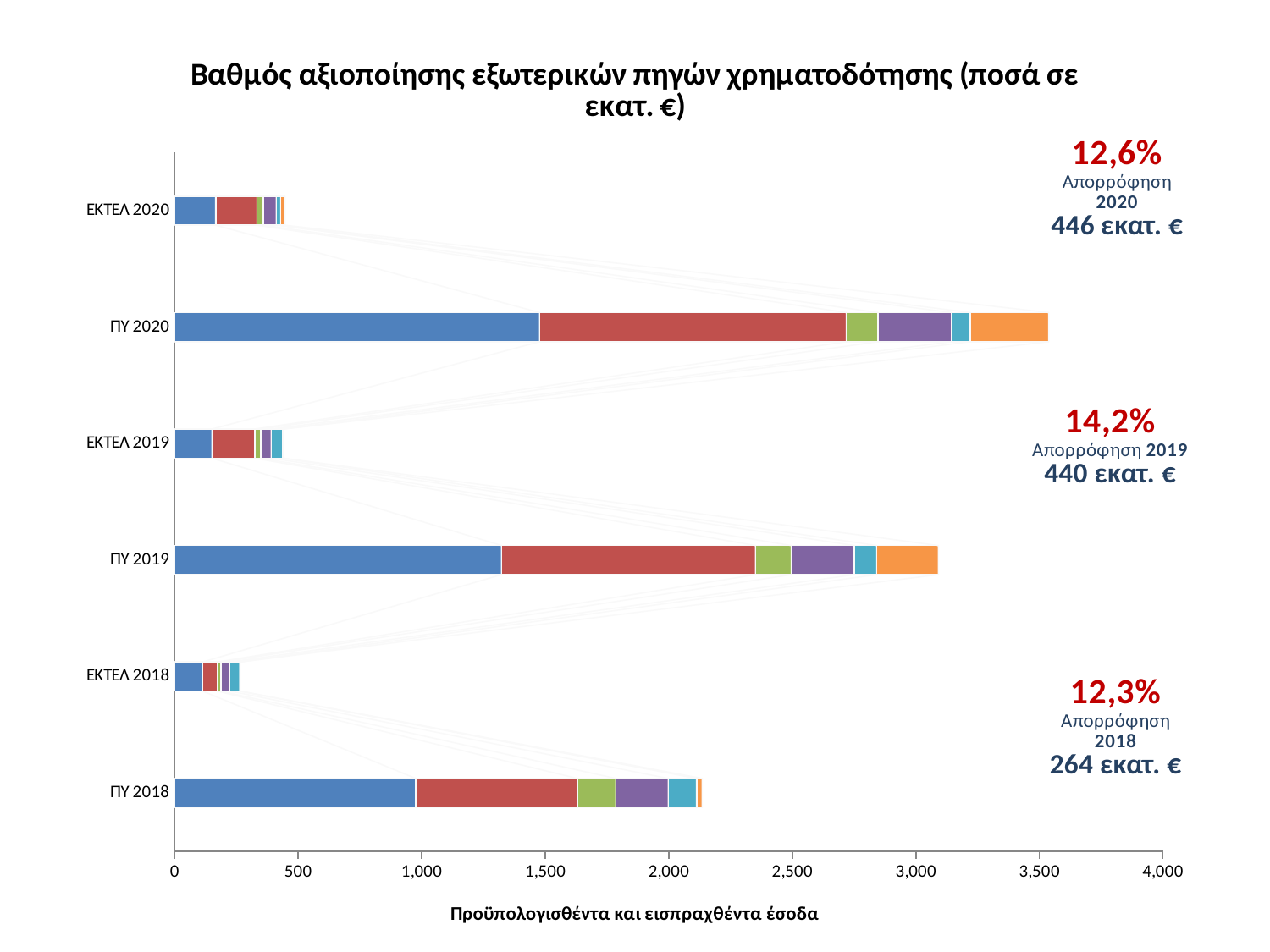
Is the total bar length for ΠΥ 2018 greater or less than 2,500? less Is the total bar length for ΕΚΤΕΛ 2020 greater or less than 500? less How many categories are shown on the vertical axis of the chart? 6 Is the total bar length for ΠΥ 2020 greater or less than 3,000? greater Which total bar is longer, ΠΥ 2019 or ΠΥ 2018? ΠΥ 2019 Which category has the shortest total bar? ΕΚΤΕΛ 2018 What amount in εκατ. € is shown next to the absorption rate for 2020? 446 εκατ. € Which category has the longest total bar? ΠΥ 2020 What is the title of the horizontal axis? Προϋπολογισθέντα και εισπραχθέντα έσοδα What absorption rate (Απορρόφηση) is shown for 2019? 14,2% Which year has the highest absorption rate shown on the slide? 2019 What kind of chart is shown on the slide? Stacked bar chart